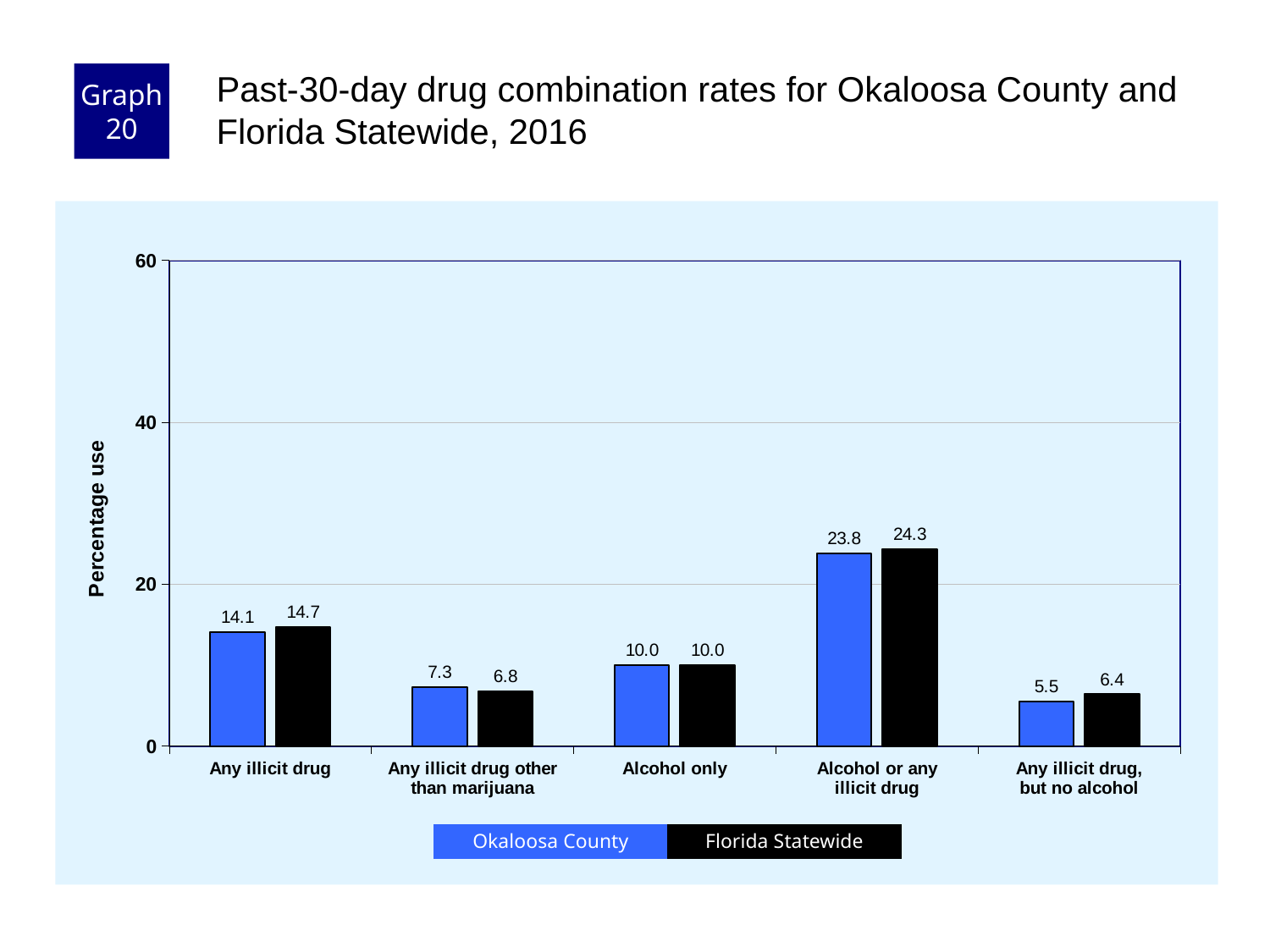
For Any illicit drug other than marijuana, which is larger: Okaloosa County or Florida Statewide? Okaloosa County What kind of chart is shown on the slide? bar chart How many series does the legend list? 2 What is the Okaloosa County value for Alcohol or any illicit drug? 23.8 Which category has the lowest Okaloosa County value? Any illicit drug, but no alcohol How many categories are shown on the x axis? 5 Which category has the highest Florida Statewide value? Alcohol or any illicit drug What is the difference between the Florida Statewide and Okaloosa County values for Alcohol or any illicit drug? 0.5 What is the label of the y axis? Percentage use Is the Okaloosa County value for Alcohol or any illicit drug greater or less than 20? greater What is the Florida Statewide value for Any illicit drug? 14.7 What is the Okaloosa County value for Any illicit drug, but no alcohol? 5.5